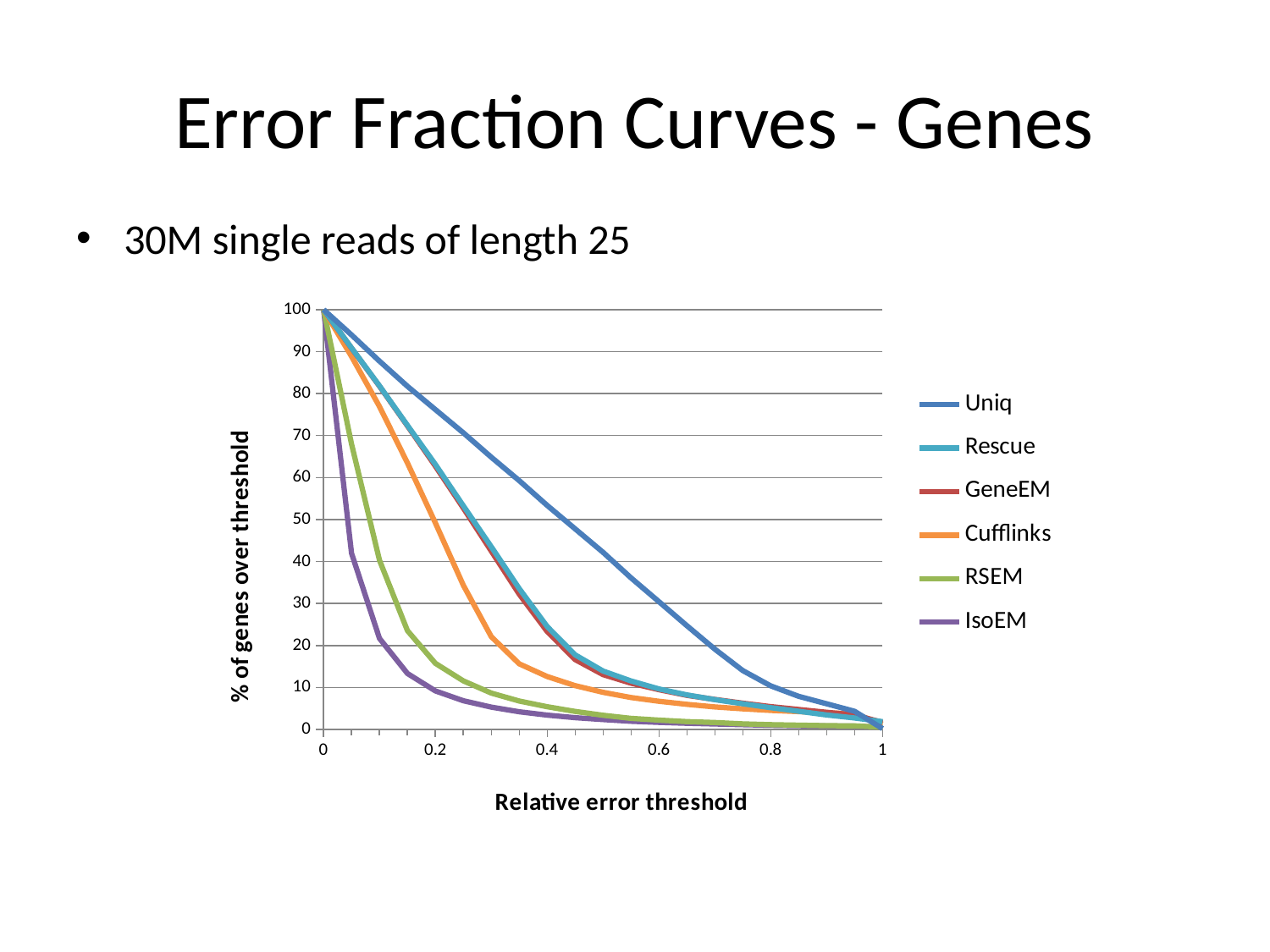
At a relative error threshold of 0.4, which is larger: the value for Uniq or the value for Cufflinks? Uniq How many series does the legend list? 6 Which series has the lowest value at a relative error threshold of 0.4? IsoEM Is the value for Uniq at a relative error threshold of 0.4 greater or less than 50? greater What kind of chart is shown on the slide? line chart What is the title of the y axis? % of genes over threshold Do the values of the Uniq series rise or fall as the relative error threshold increases? fall Which series has the highest value at a relative error threshold of 0.4? Uniq Is the value for Cufflinks at a relative error threshold of 0.4 greater or less than 20? less Is the value for RSEM at a relative error threshold of 0.2 greater or less than 20? less What is the title of the x axis? Relative error threshold